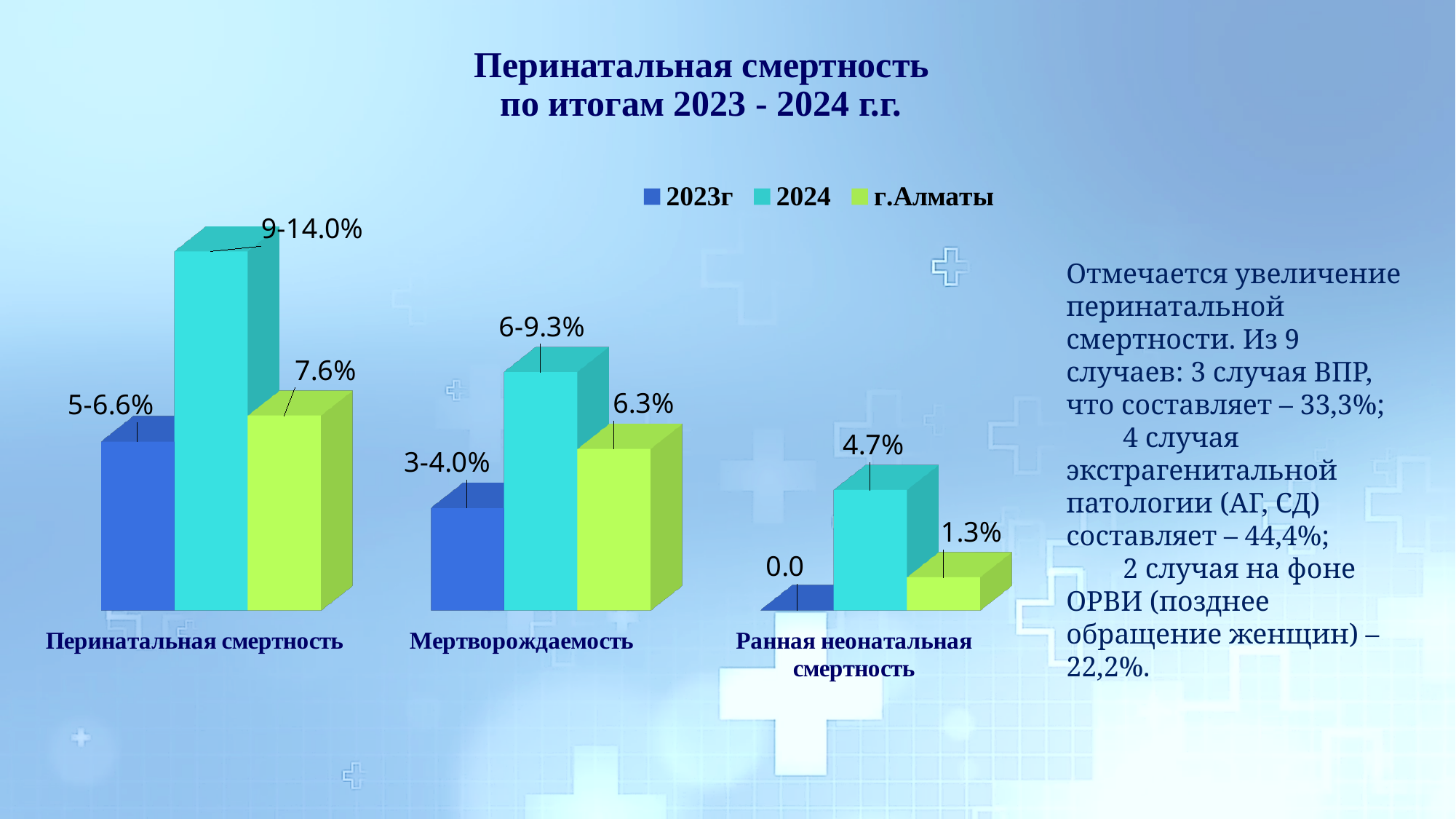
What is the data label for the 2023г series in the Перинатальная смертность category? 5-6.6% Which category has the highest value for the г.Алматы series? Перинатальная смертность What kind of chart is shown on the slide? bar chart In the Ранная неонатальная смертность category, which is larger: the 2024 value or the г.Алматы value? 2024 Which category has the lowest value for the 2024 series? Ранная неонатальная смертность How many series does the legend list? 3 What is the difference between the г.Алматы values for Перинатальная смертность and Мертворождаемость? 1.3% What is the data label for the 2024 series in the Перинатальная смертность category? 9-14.0% What is the value for the 2023г series in the Ранная неонатальная смертность category? 0.0 What is the value for г.Алматы in the Мертворождаемость category? 6.3% How many categories are shown on the x axis? 3 What is the value for the 2024 series in the Ранная неонатальная смертность category? 4.7%